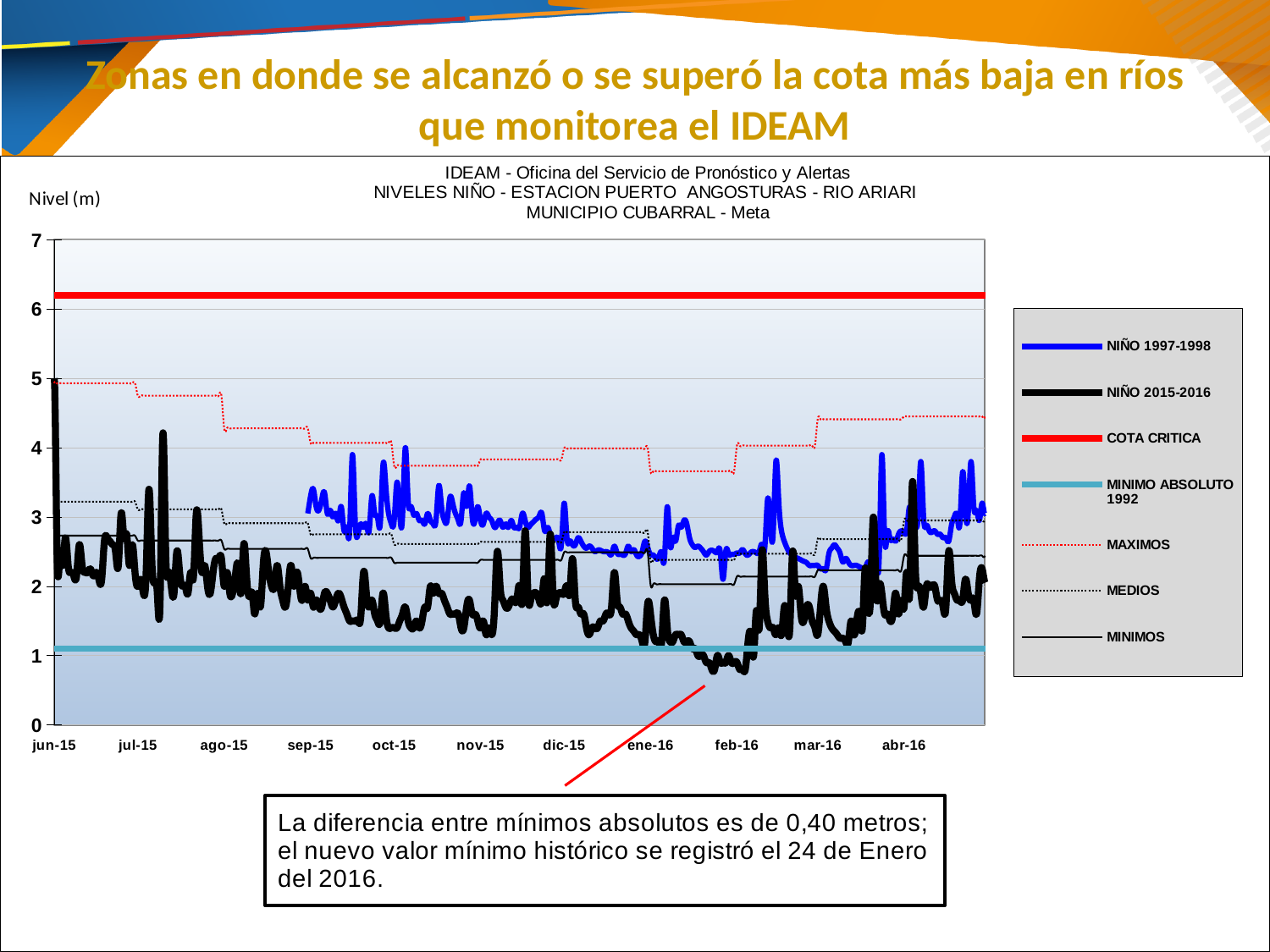
Is the lowest value of the NIÑO 2015-2016 line, reached around ene-16, greater or less than 1? less At oct-15, which line is higher: NIÑO 1997-1998 or NIÑO 2015-2016? NIÑO 1997-1998 How many series does the chart legend list? 7 What type of chart is shown on the slide? line chart Is the value of the COTA CRITICA line greater or less than 6? greater Which series has the highest values across the whole chart? COTA CRITICA Does the NIÑO 2015-2016 line generally rise or fall from jun-15 to ene-16? fall What is the label of the y axis of the chart? Nivel (m) How many month labels are shown on the x axis of the chart? 11 Is the value of the MAXIMOS line at ene-16 greater or less than 4? less What colour is the COTA CRITICA line in the chart? red